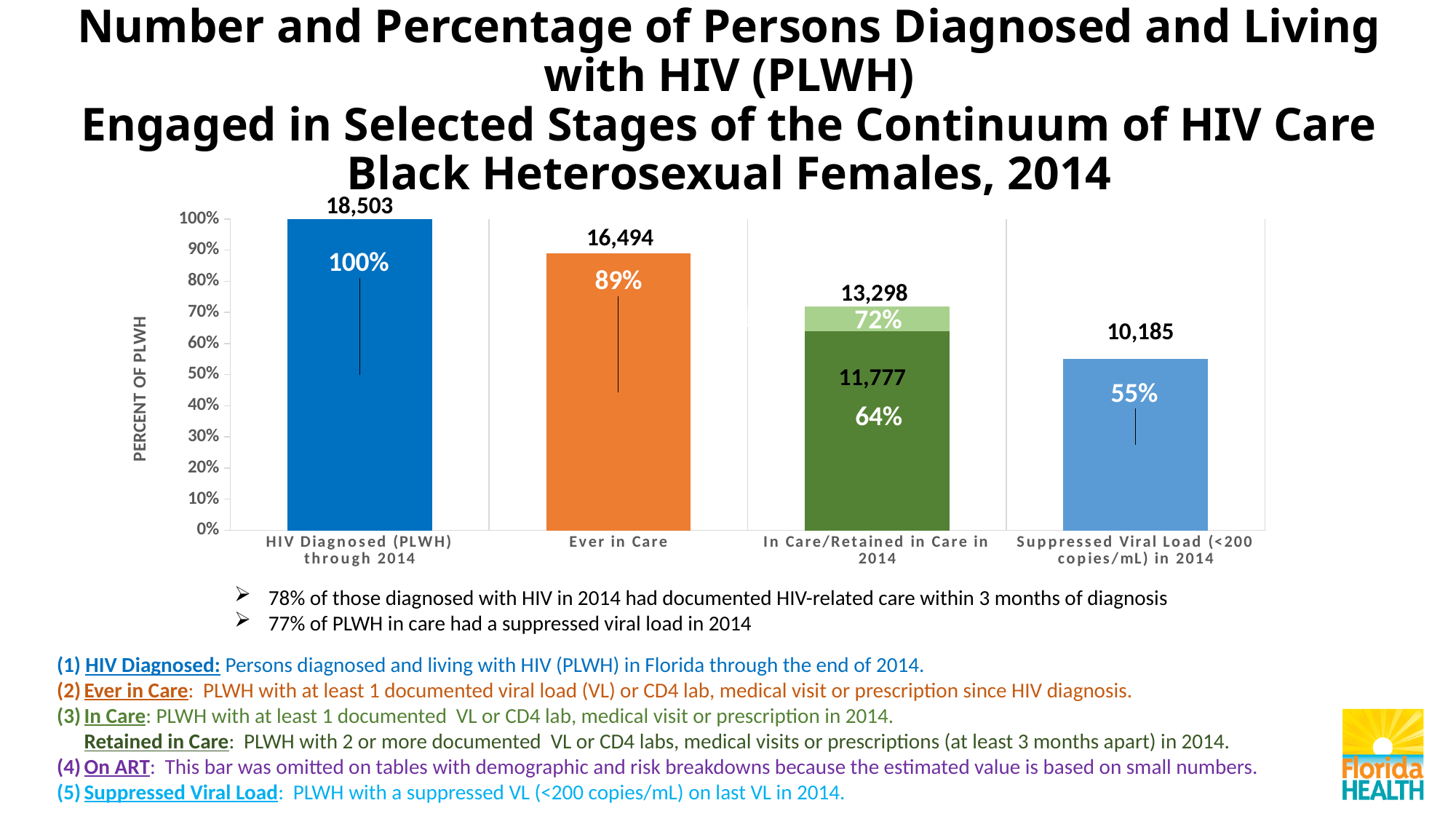
What is the difference in percentage points between 'Ever in Care' and 'Suppressed Viral Load (<200 copies/mL) in 2014'? 34 Which stage of the continuum has the lowest percentage of PLWH? Suppressed Viral Load (<200 copies/mL) in 2014 What percentage is shown for the 'Ever in Care' bar? 89% What number is shown at the top of the 'In Care/Retained in Care in 2014' bar? 13,298 Which is larger: the percentage for 'Ever in Care' or the percentage for 'In Care/Retained in Care in 2014'? Ever in Care How many stages (bars) are shown along the x axis of the chart? 4 Do the percentages rise or fall moving from left to right across the stages of the continuum? fall What number is shown for the darker green 'Retained in Care' portion of the 'In Care/Retained in Care in 2014' bar? 11,777 Which stage of the continuum has the highest number of persons? HIV Diagnosed (PLWH) through 2014 What percentage is shown for the 'Suppressed Viral Load (<200 copies/mL) in 2014' bar? 55% What is the number of persons shown for the 'HIV Diagnosed (PLWH) through 2014' bar? 18,503 What is the difference in number of persons between 'HIV Diagnosed (PLWH) through 2014' and 'Ever in Care'? 2,009